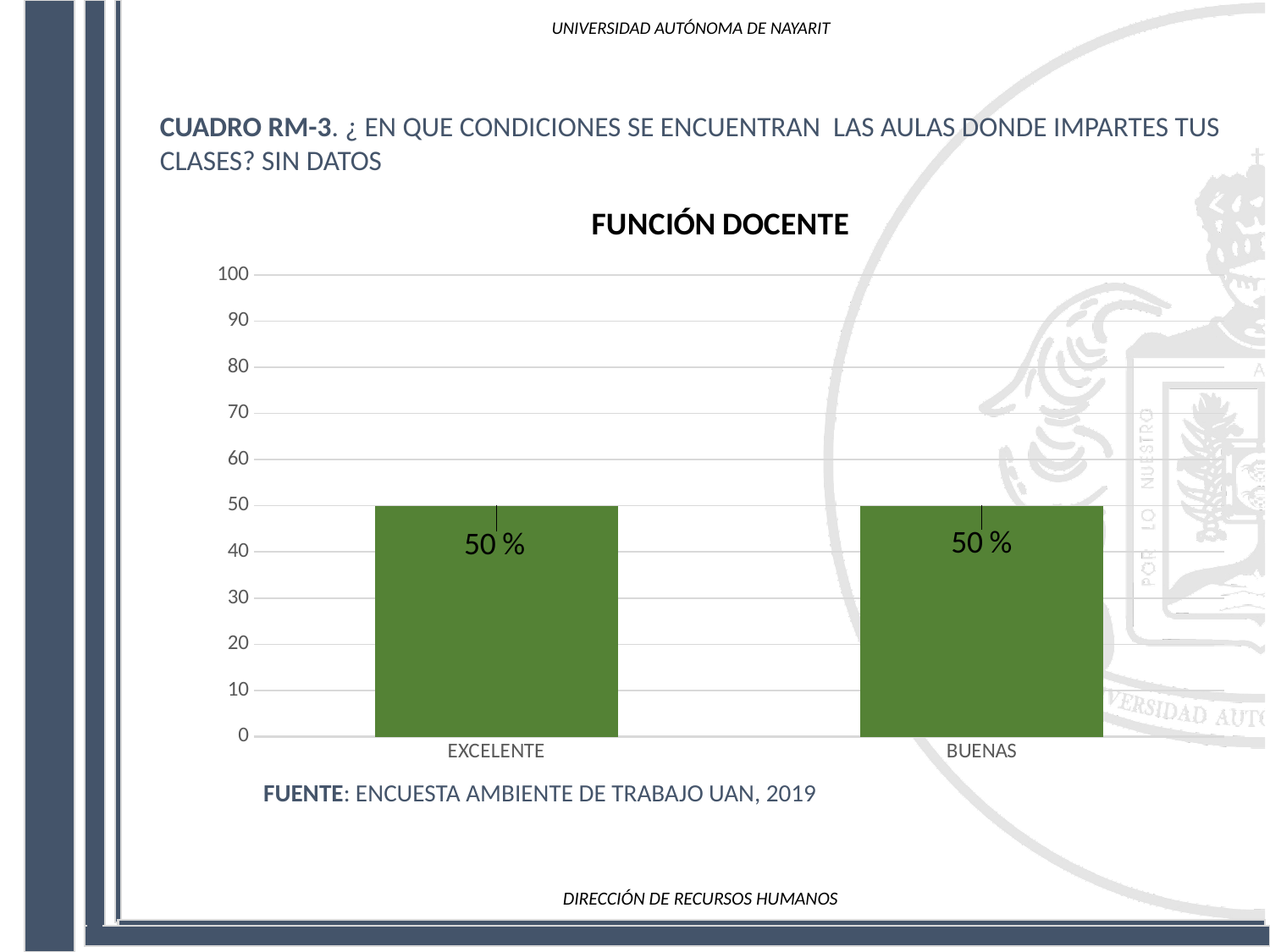
What is the value for EXCELENTE? 50 % What is the total of the values for EXCELENTE and BUENAS? 100 % What is the highest value shown on the y axis? 100 Is the value for BUENAS greater or less than 40? greater What is the value for BUENAS? 50 % What colour are the bars in the chart? green What kind of chart is shown on the slide? bar chart What is the difference between the values for EXCELENTE and BUENAS? 0 Is the value for EXCELENTE greater or less than 60? less How many categories are shown on the x axis? 2 What is the title of the chart? FUNCIÓN DOCENTE